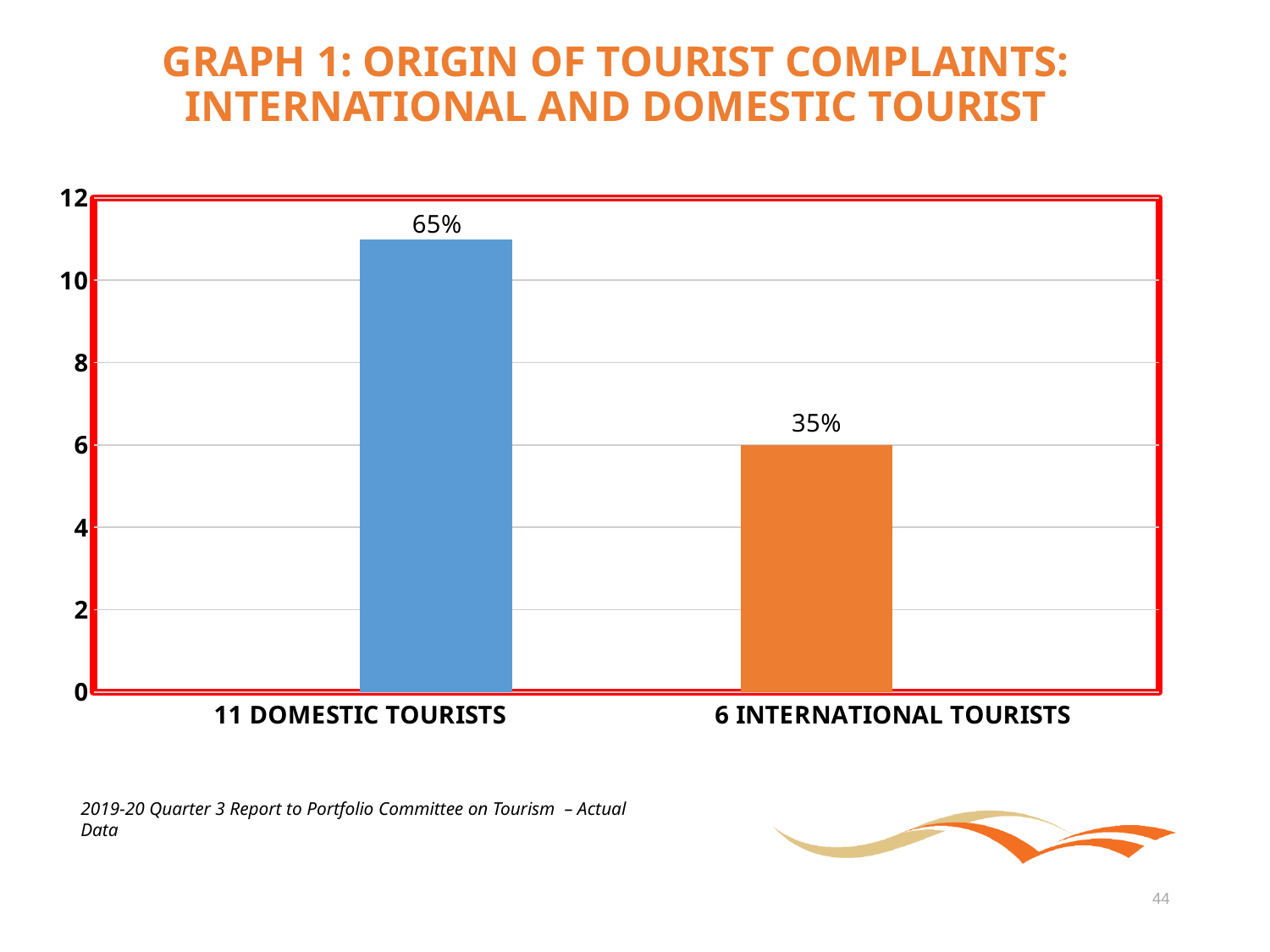
Which category has the shorter bar? 6 INTERNATIONAL TOURISTS What is the difference between the percentage labels for domestic tourists and international tourists? 30 percentage points How many categories are shown on the chart? 2 What colour is the bar for 6 INTERNATIONAL TOURISTS? Orange Which category has the taller bar? 11 DOMESTIC TOURISTS Is the value for 11 DOMESTIC TOURISTS greater or less than 10 on the vertical axis? greater What percentage is shown above the bar for 6 INTERNATIONAL TOURISTS? 35% Is the bar for domestic tourists or the bar for international tourists larger? Domestic tourists What do the two percentage labels on the chart add up to? 100% What type of chart is shown on the slide? Bar chart Is the value for 6 INTERNATIONAL TOURISTS greater or less than 8 on the vertical axis? less What percentage is shown above the bar for 11 DOMESTIC TOURISTS? 65%